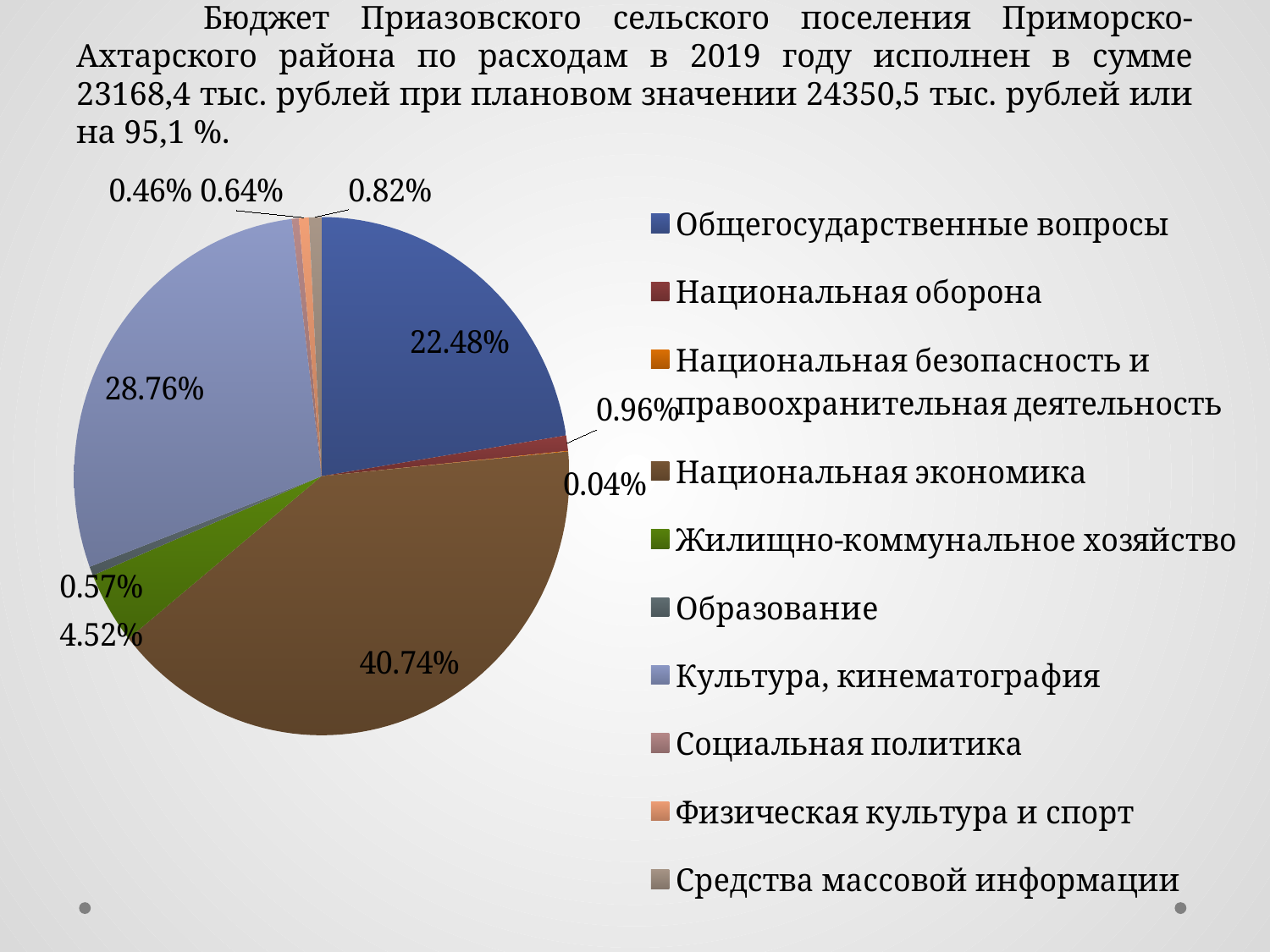
Which category has the largest share of the pie? Национальная экономика Which is larger: the share of Общегосударственные вопросы or the share of Культура, кинематография? Культура, кинематография What share of the pie does Средства массовой информации have? 0.82% What share of the pie does Национальная экономика have? 40.74% What share of the pie does Национальная оборона have? 0.96% Which category has the smallest share of the pie? Национальная безопасность и правоохранительная деятельность How many categories does the legend list? 10 What is the difference between the shares of Национальная экономика and Культура, кинематография? 11.98% What share of the pie does Культура, кинематография have? 28.76% What share of the pie does Жилищно-коммунальное хозяйство have? 4.52% What type of chart is shown on the slide? pie chart What share of the pie does Общегосударственные вопросы have? 22.48%